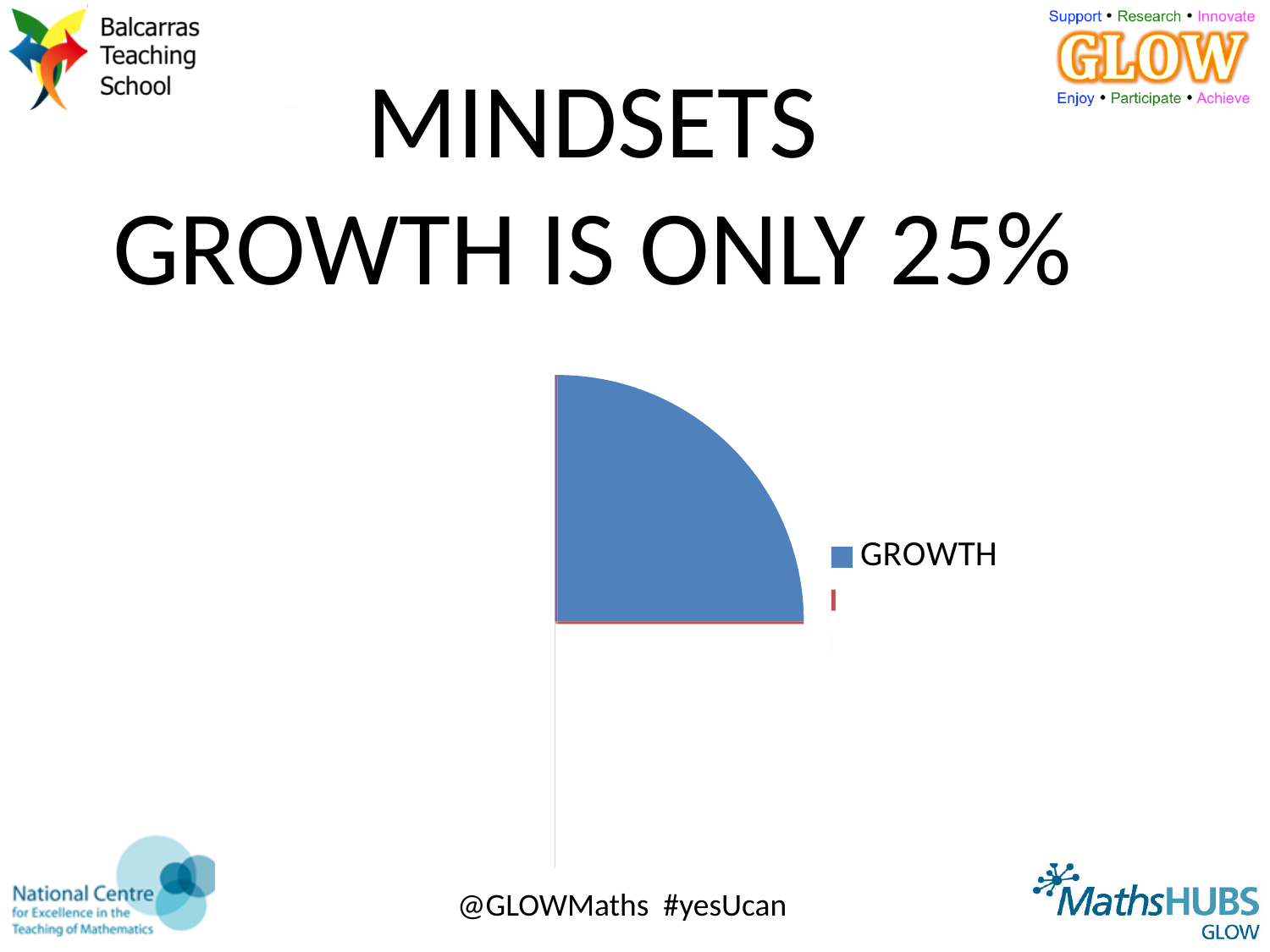
What kind of chart is shown on the slide? pie chart Is the GROWTH slice's share of the pie chart greater or less than 50%? less What is the readable legend entry in the pie chart? GROWTH What share of the pie chart does the GROWTH slice represent? 25% What colour is the GROWTH slice in the pie chart? blue